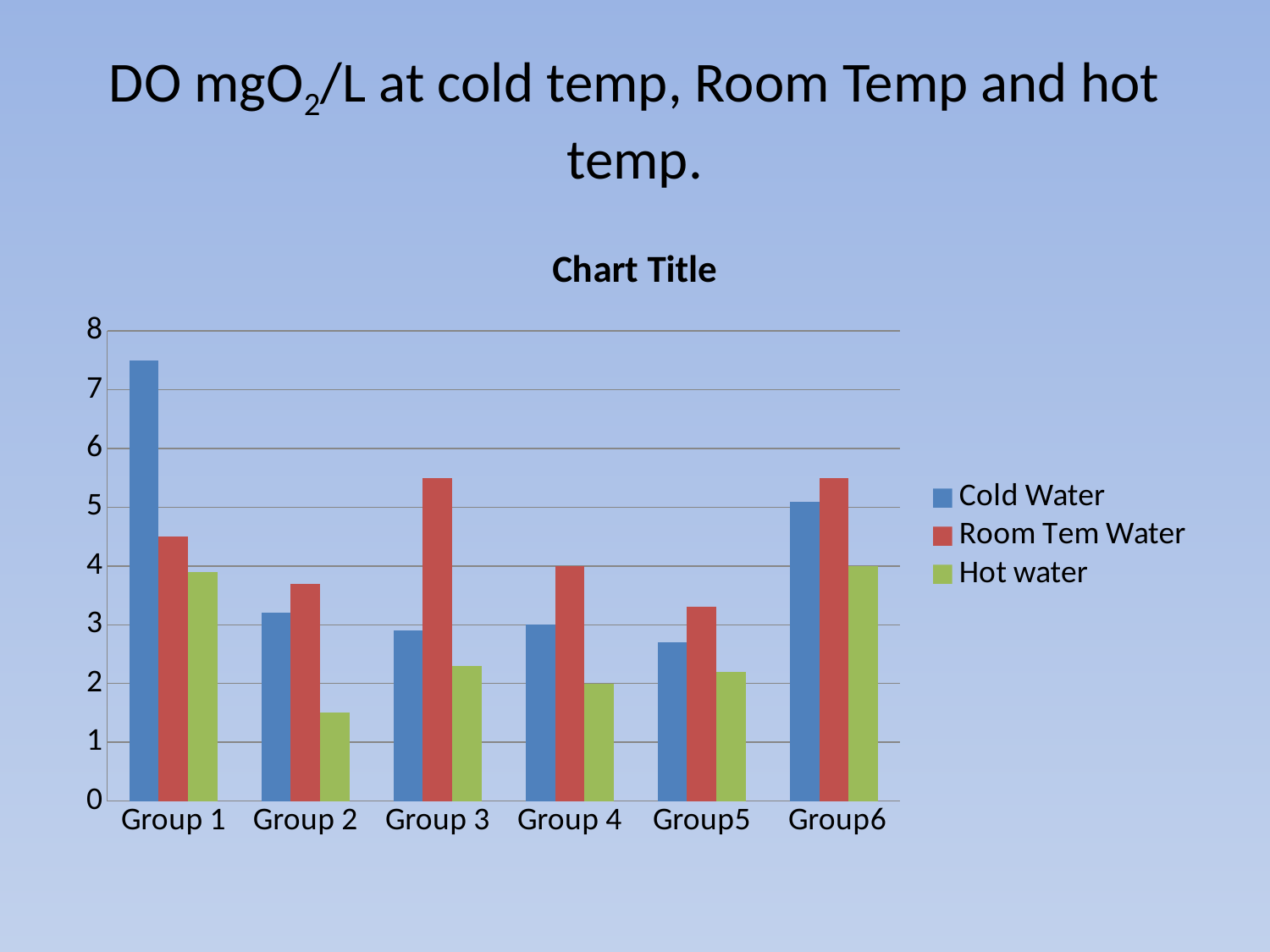
Is the Cold Water value for Group5 greater or less than 3? less For Group 3, which is larger: the Cold Water value or the Room Tem Water value? Room Tem Water How many groups are shown on the x axis of the chart? 6 Which group has the highest Cold Water value? Group 1 What kind of chart is shown on the slide? bar chart How many series does the chart's legend list? 3 Which group has the lowest Hot water value? Group 2 For Group 1, which is larger: the Cold Water value or the Room Tem Water value? Cold Water Is the Room Tem Water value for Group 3 greater or less than 5? greater Is the Hot water value for Group 2 greater or less than 2? less What are the three series listed in the chart's legend? Cold Water, Room Tem Water, Hot water